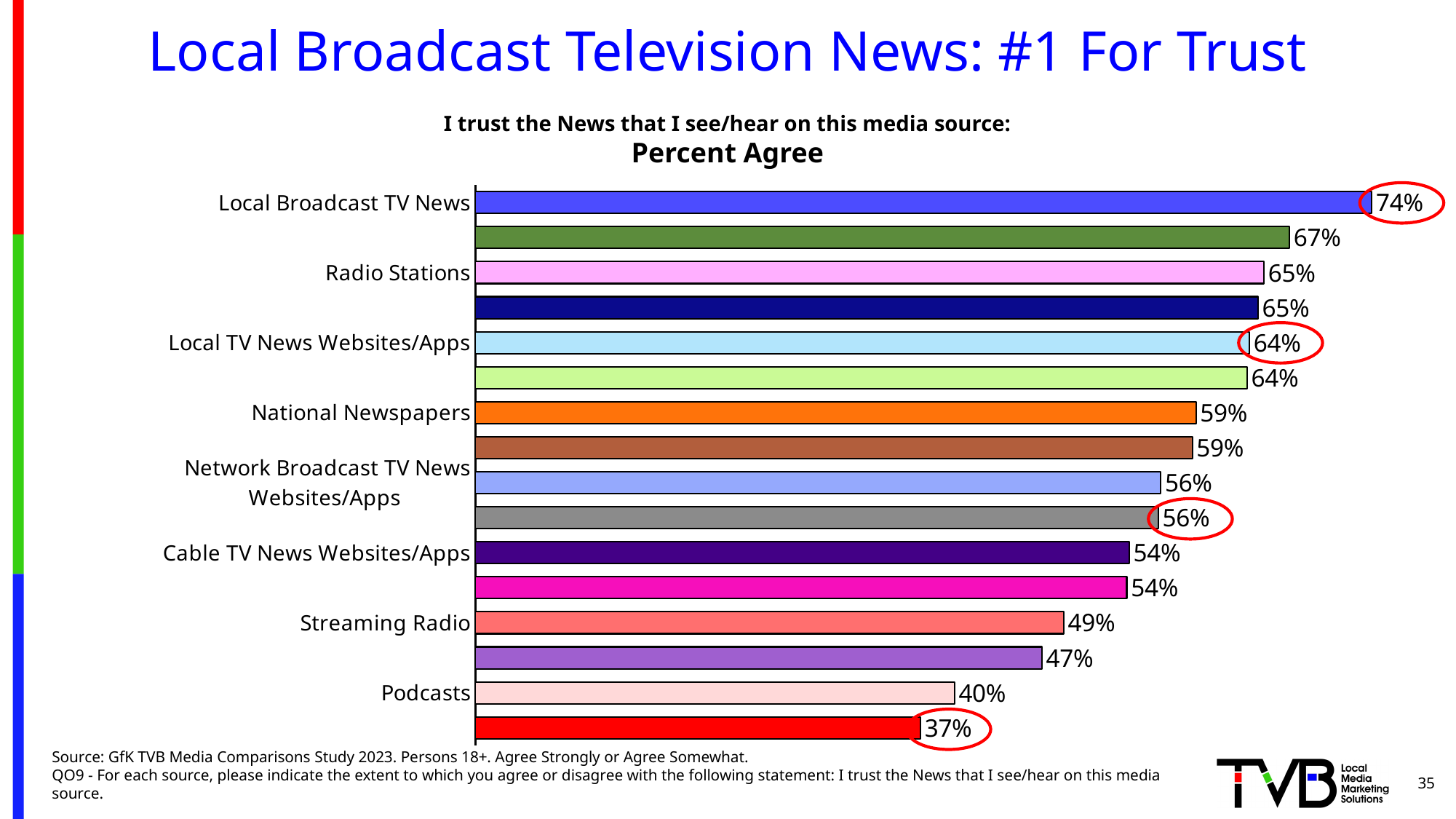
How many percentage points higher is Local Broadcast TV News than Radio Stations? 9 What is the value for Radio Stations? 65% Do the bar values increase or decrease from the top of the chart to the bottom? Decrease What percent agree is shown for Local Broadcast TV News? 74% What is the difference between Streaming Radio and Podcasts? 9 What kind of chart is shown on the slide? Bar chart What percent agree is shown for Podcasts? 40% Which media source has the highest percent agree? Local Broadcast TV News How many bars are plotted on the chart? 16 What is the value for Network Broadcast TV News Websites/Apps? 56% What is the smallest value shown on the chart? 37% Which is larger, the value for National Newspapers or for Cable TV News Websites/Apps? National Newspapers